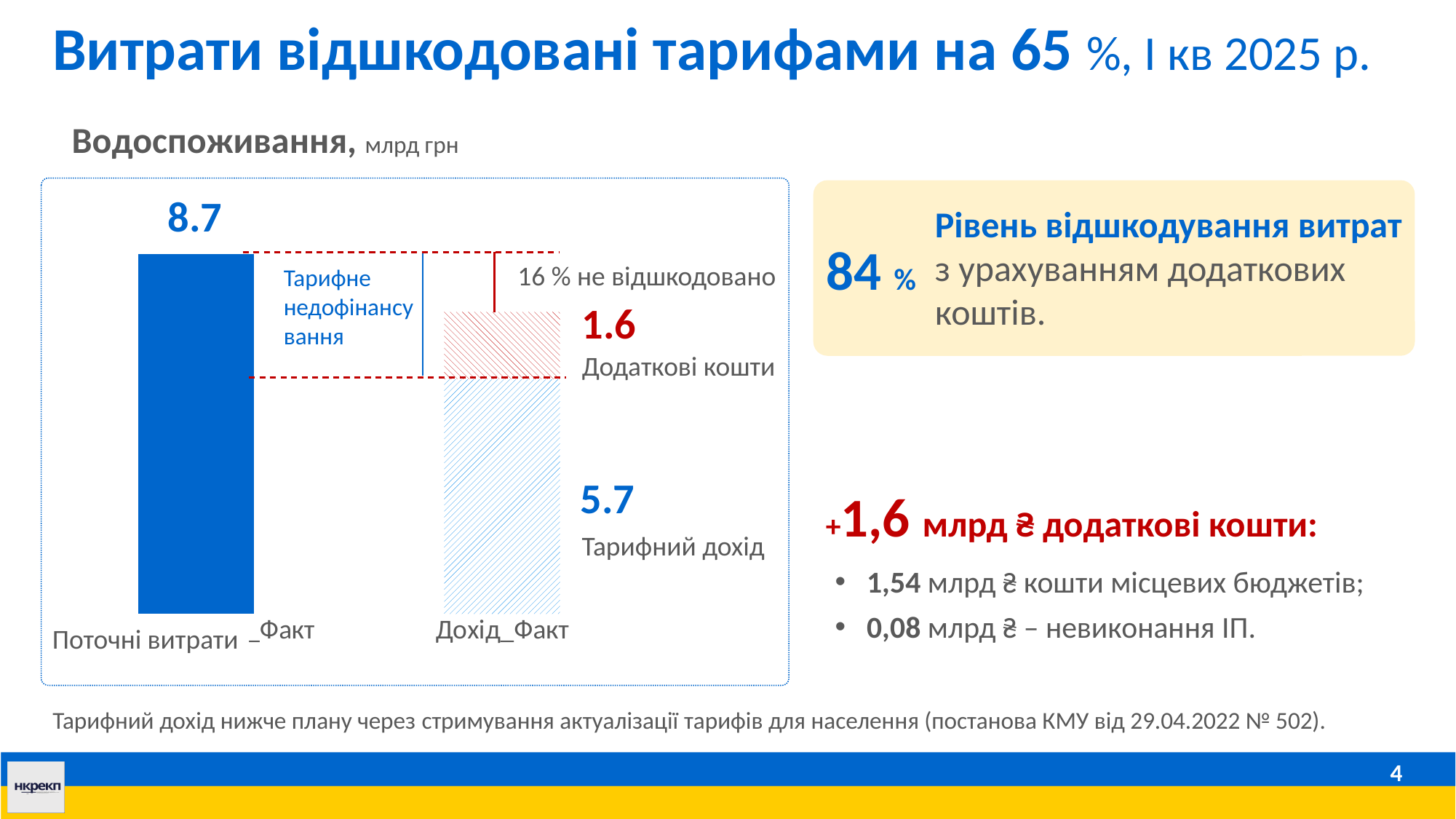
How many bars (categories) are shown in the chart? 2 What is the title of the chart and its unit? Водоспоживання, млрд грн Which segment of the Дохід_Факт bar is larger: Тарифний дохід or Додаткові кошти? Тарифний дохід What kind of chart is shown on the slide? Bar chart What is the value of the Тарифний дохід segment in the Дохід_Факт bar? 5.7 What is the value of the Поточні витрати_Факт bar? 8.7 According to the annotation on the chart, what percentage is not reimbursed (не відшкодовано)? 16 % What is the total of the stacked Дохід_Факт bar (Тарифний дохід plus Додаткові кошти)? 7.3 Which bar is the tallest in the chart? Поточні витрати_Факт What is the value of the Додаткові кошти segment in the Дохід_Факт bar? 1.6 What is the difference between Поточні витрати_Факт (8.7) and Тарифний дохід (5.7)? 3.0 Which is larger: Поточні витрати_Факт or Тарифний дохід? Поточні витрати_Факт